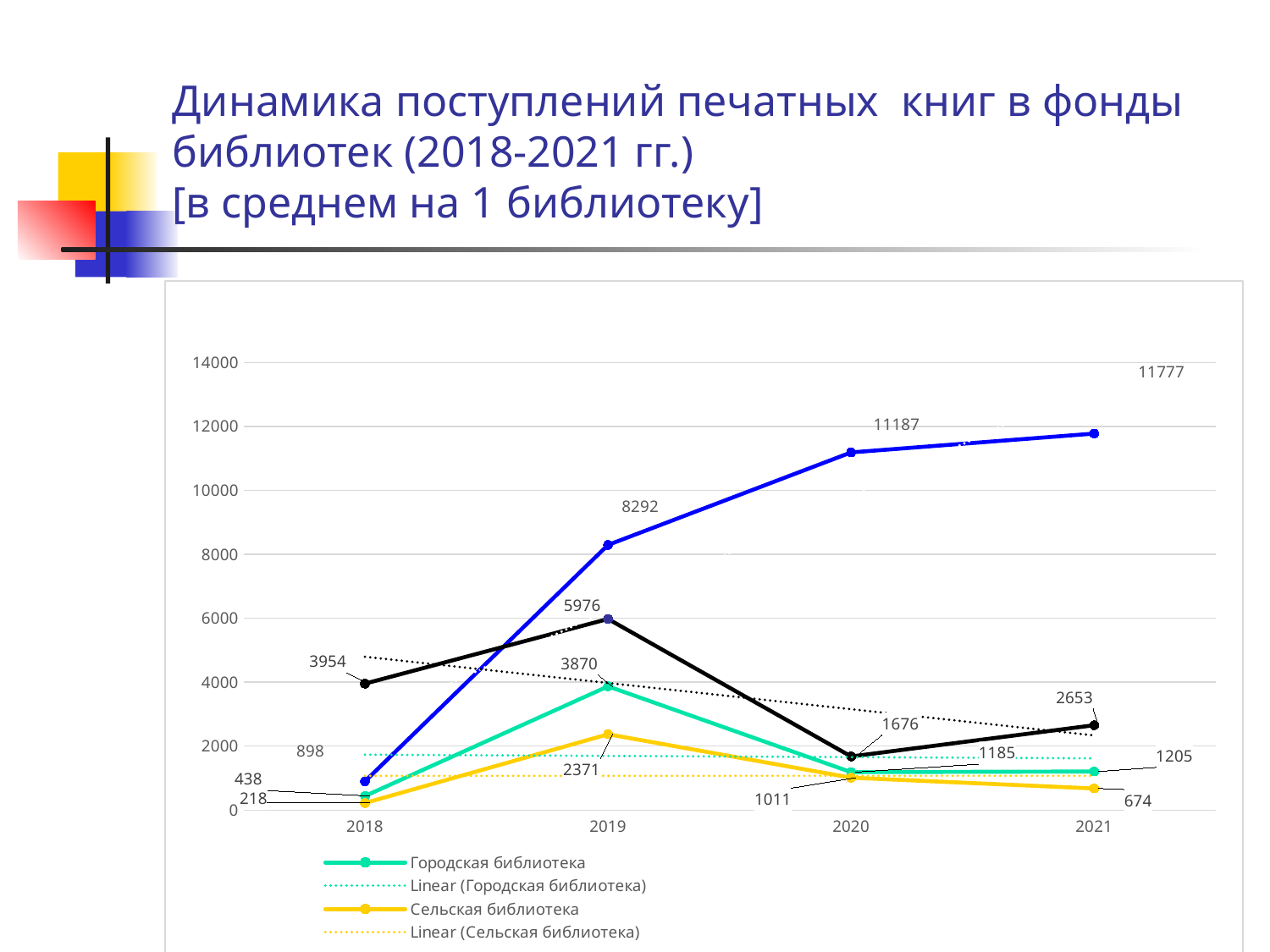
In which year is the value for Сельская библиотека highest? 2019 How many entries does the legend list? 4 Does the value for Сельская библиотека rise or fall from 2019 to 2021? fall What is the value for Городская библиотека in 2018? 438 What is the value for Сельская библиотека in 2018? 218 What kind of chart is shown on the slide? line chart What is the value for Сельская библиотека in 2021? 674 What is the difference between Городская библиотека and Сельская библиотека in 2019? 1499 Which is larger in 2021: Городская библиотека or Сельская библиотека? Городская библиотека What is the value for Сельская библиотека in 2019? 2371 What is the value for Городская библиотека in 2019? 3870 How many years are shown on the x axis? 4